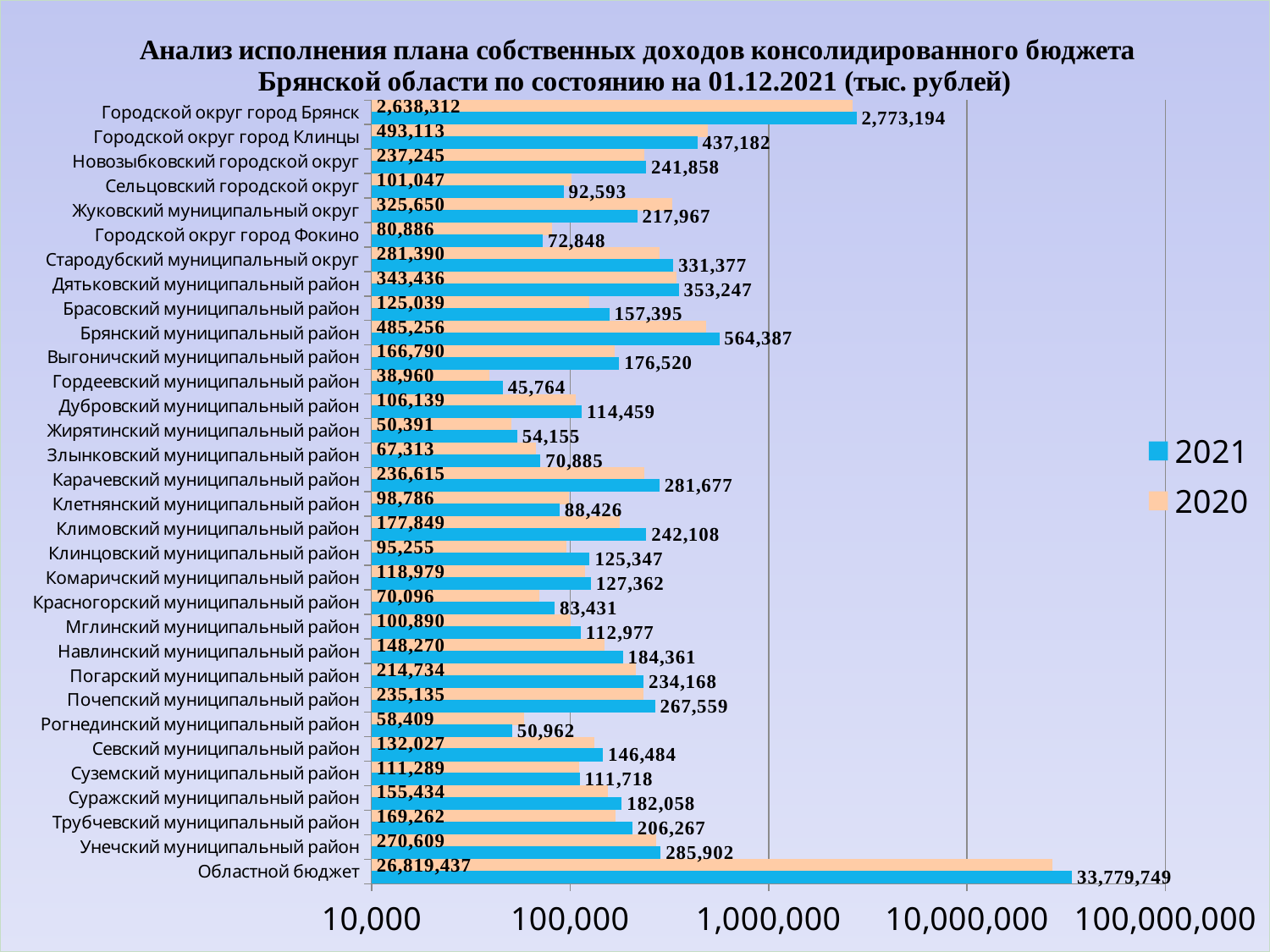
Which category has the lowest 2021 value? Гордеевский муниципальный район For Жуковский муниципальный округ, which year has the larger value, 2020 or 2021? 2020 What is the 2020 value for Городской округ город Брянск? 2,638,312 What is the difference between the 2020 and 2021 values for Сельцовский городской округ? 8,454 Which category has the highest 2021 value? Областной бюджет What is the 2021 value for Брянский муниципальный район? 564,387 How many categories are shown on the chart? 32 What kind of chart is shown on the slide? Bar chart What is the 2021 value for Областной бюджет? 33,779,749 Which category has the lowest 2020 value? Гордеевский муниципальный район What is the difference between the 2021 and 2020 values for Городской округ город Брянск? 134,882 How many series does the legend list? 2